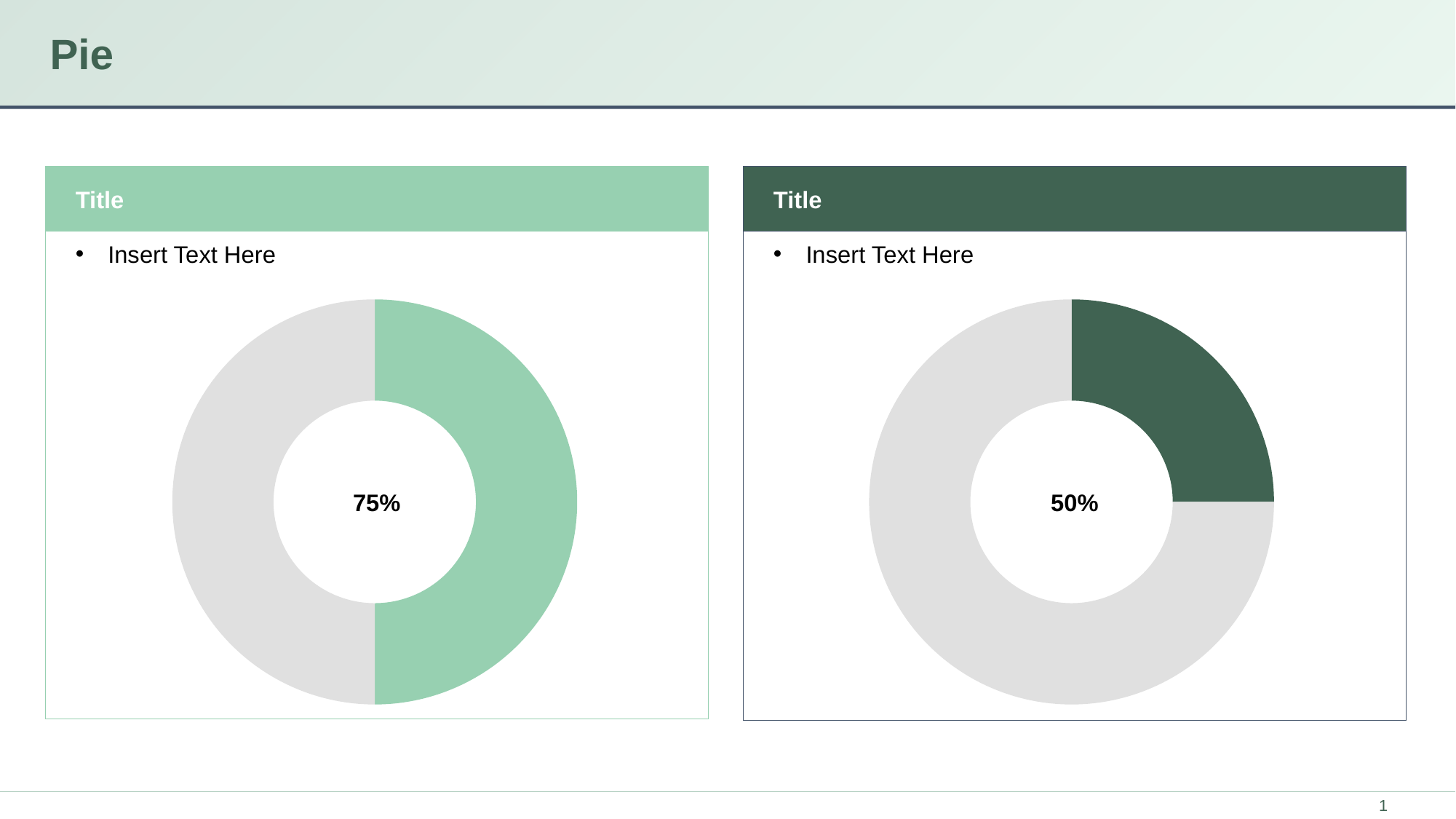
Which chart shows the larger printed percentage, the left chart or the right chart? the left chart How many slices does the left chart have? 2 What percentage is printed in the centre of the right chart? 50% What colour is the highlighted slice in the right chart? dark green How many slices does the right chart have? 2 What is the difference between the percentage printed on the left chart and the percentage printed on the right chart? 25% Is the percentage printed on the left chart greater or less than 50%? greater What kind of chart is shown in the right panel? doughnut chart What colour is the highlighted slice in the left chart? light green What percentage is printed in the centre of the left chart? 75% What kind of chart is shown in the left panel? doughnut chart